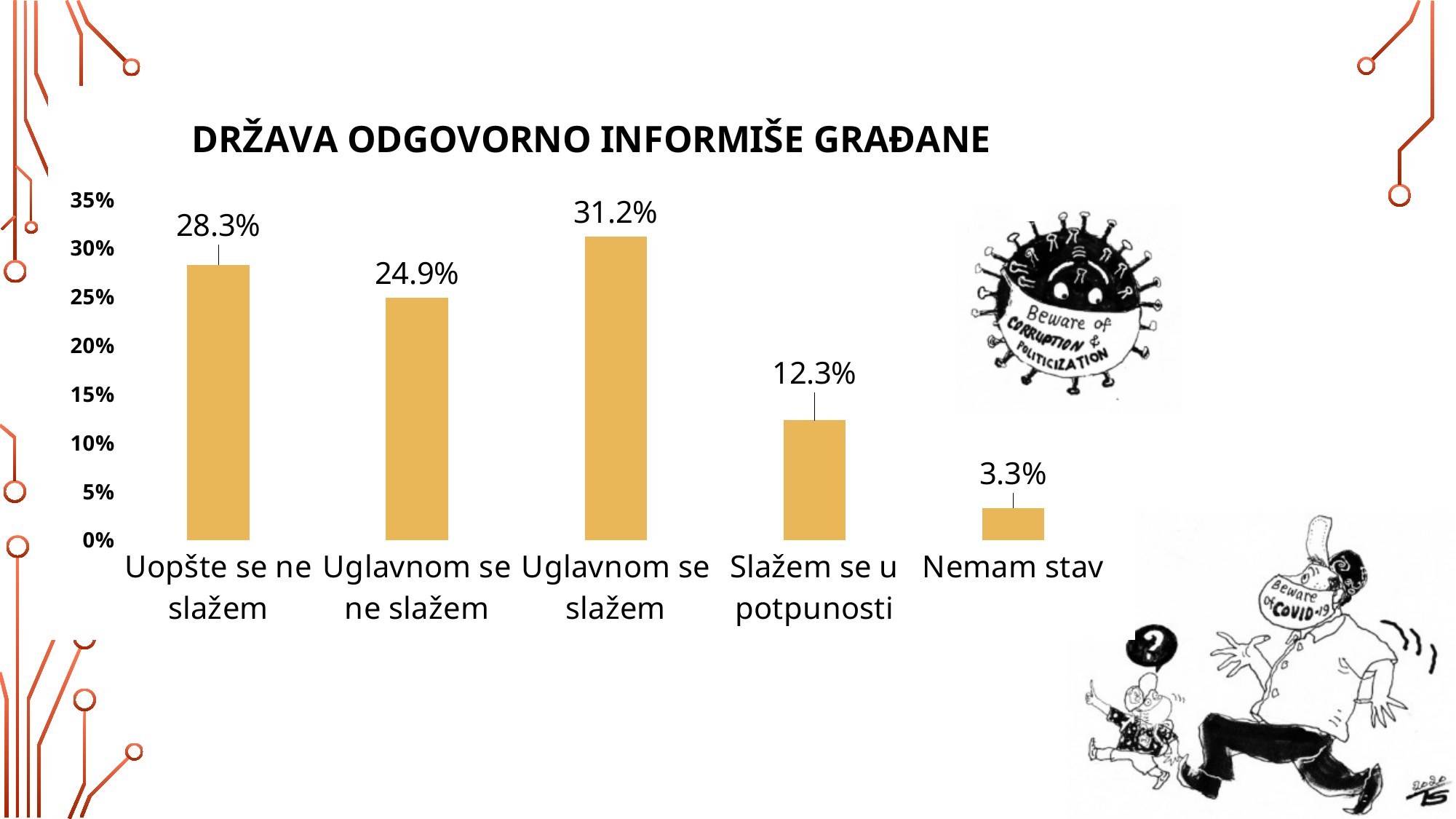
Is the value for "Uglavnom ne slažem" greater or less than 20%? greater How many categories are shown on the chart? 5 Which category has the highest value? Uglavnom se slažem What is the value for "Uglavnom se slažem"? 31.2% What is the value for "Nemam stav"? 3.3% Which category has the lowest value? Nemam stav What kind of chart is shown on the slide? bar chart What is the difference between "Uopšte se ne slažem" and "Uglavnom ne slažem"? 3.4% What is the value for "Slažem se u potpunosti"? 12.3% Which is larger, "Uopšte se ne slažem" or "Slažem se u potpunosti"? Uopšte se ne slažem What is the title of the chart? DRŽAVA ODGOVORNO INFORMIŠE GRAĐANE What is the difference between "Uglavnom se slažem" and "Nemam stav"? 27.9%